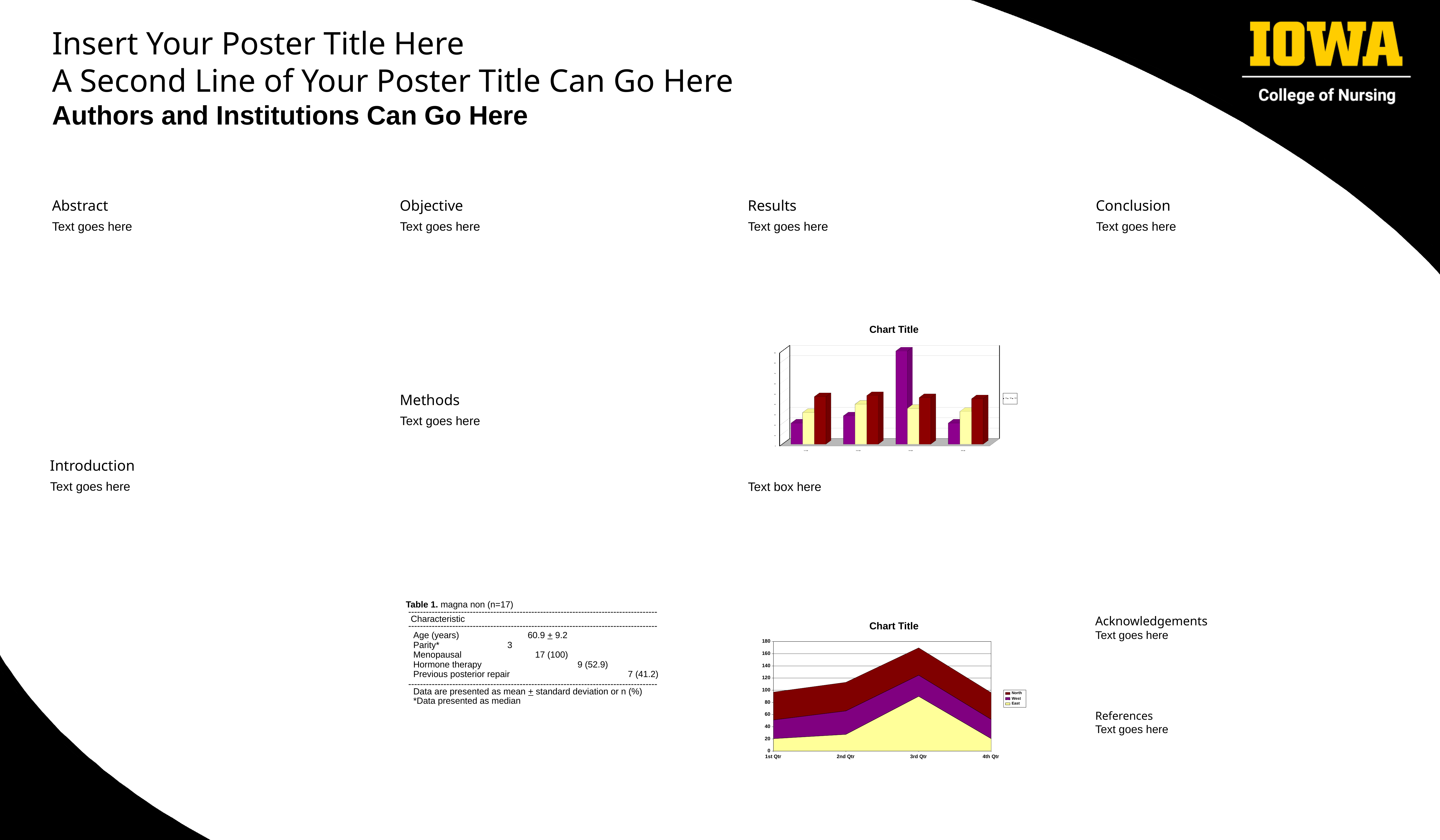
In the lower area chart, is the East value for 1st Qtr greater or less than 40? less How many series does the legend of the lower area chart list? 3 In the lower area chart, does the stacked total rise or fall from 3rd Qtr to 4th Qtr? fall How many quarters are plotted along the x axis of the lower area chart? 4 In the lower area chart, is the stacked total for 3rd Qtr greater or less than 140? greater What kind of chart is the upper chart on the slide (the one above 'Text box here')? bar chart What kind of chart is the lower chart on the slide (the one with quarters on the x axis)? area chart In the lower area chart, what colour is the East series? yellow In the lower area chart, which quarter has the highest stacked total? 3rd Qtr What are the series names in the legend of the lower area chart? North, West, East How many bars are in each group of the upper bar chart? 3 How many groups of bars does the upper bar chart show? 4